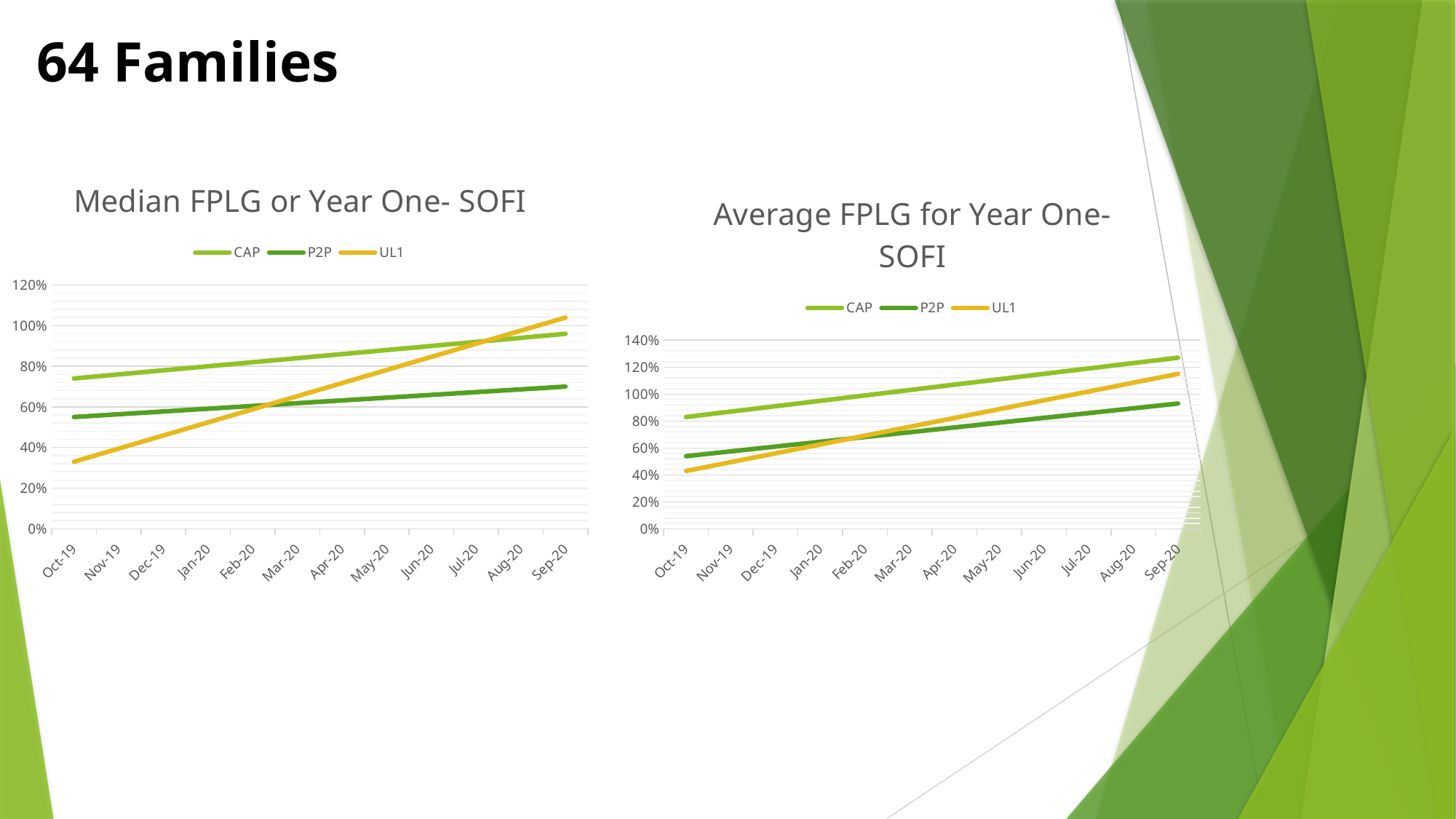
In the 'Median FPLG or Year One- SOFI' chart, which is larger at Oct-19, CAP or P2P? CAP In the 'Median FPLG or Year One- SOFI' chart, is the UL1 value for Sep-20 greater or less than 100%? greater In the 'Average FPLG for Year One- SOFI' chart, which series has the highest value at Sep-20? CAP In the 'Median FPLG or Year One- SOFI' chart, which series has the lowest value at Oct-19? UL1 In the 'Average FPLG for Year One- SOFI' chart, is the UL1 value for Oct-19 greater or less than 60%? less In the 'Average FPLG for Year One- SOFI' chart, is the CAP value for Sep-20 greater or less than 120%? greater What kind of chart is the 'Median FPLG or Year One- SOFI' chart? line chart How many series does the legend of the 'Average FPLG for Year One- SOFI' chart list? 3 What are the three series listed in the legend of the 'Median FPLG or Year One- SOFI' chart? CAP, P2P, UL1 In the 'Median FPLG or Year One- SOFI' chart, does the UL1 line rise or fall from Oct-19 to Sep-20? rise How many months are shown on the x axis of the 'Median FPLG or Year One- SOFI' chart? 12